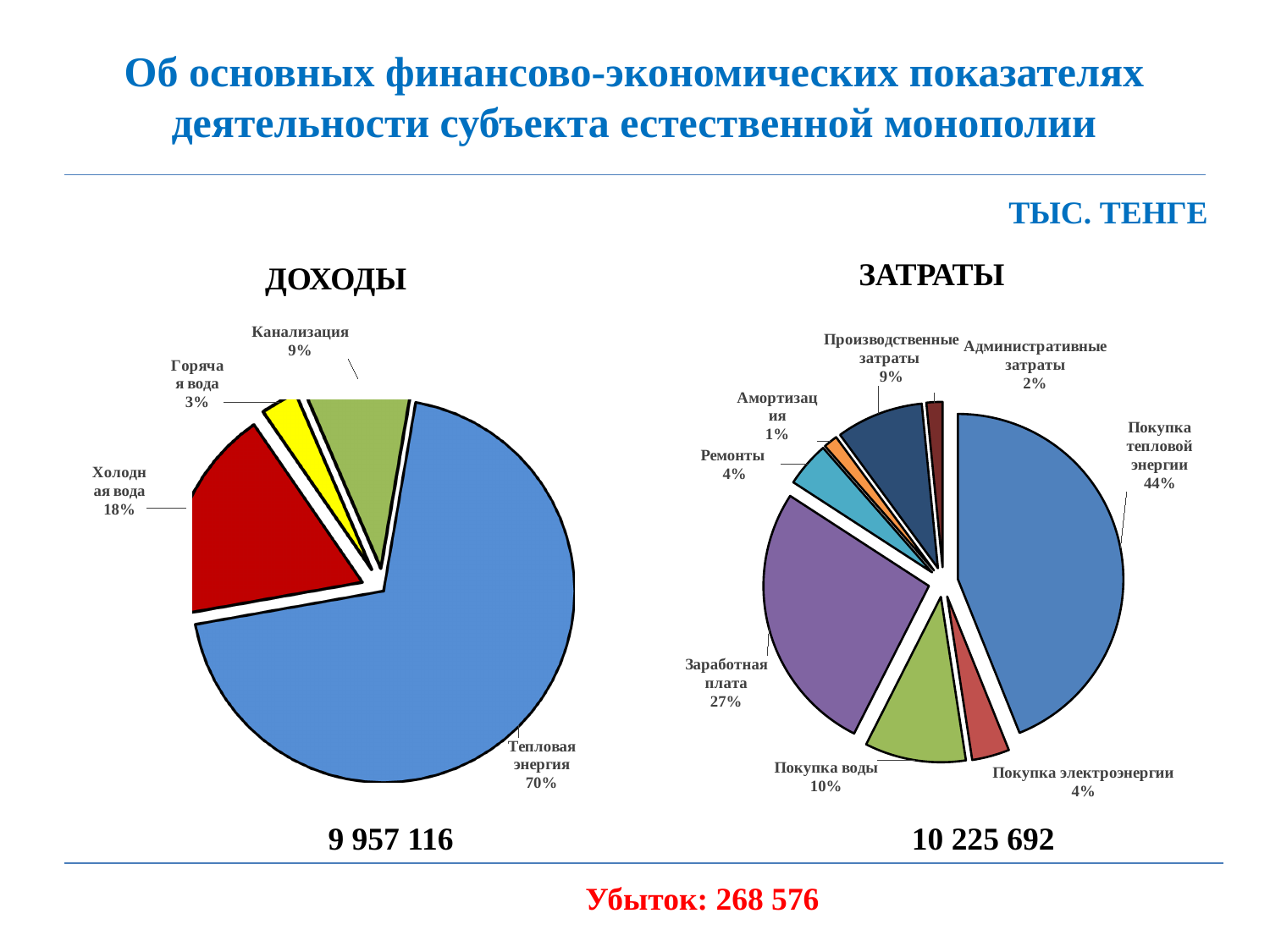
What type of chart is the ДОХОДЫ chart? Pie chart In the ЗАТРАТЫ chart, what is the difference in percentage points between Покупка тепловой энергии and Заработная плата? 17 In the ЗАТРАТЫ chart, which is larger: Производственные затраты or Административные затраты? Производственные затраты In the ЗАТРАТЫ chart, what share does Покупка воды have? 10% In the ДОХОДЫ chart, how many slices does the pie have? 4 In the ЗАТРАТЫ chart, which category has the largest share? Покупка тепловой энергии In the ДОХОДЫ chart, what share does Холодная вода have? 18% In the ЗАТРАТЫ chart, which category has the smallest share? Амортизация In the ДОХОДЫ chart, what share does Тепловая энергия have? 70% In the ДОХОДЫ chart, which category has the smallest share? Горячая вода In the ЗАТРАТЫ chart, how many slices does the pie have? 8